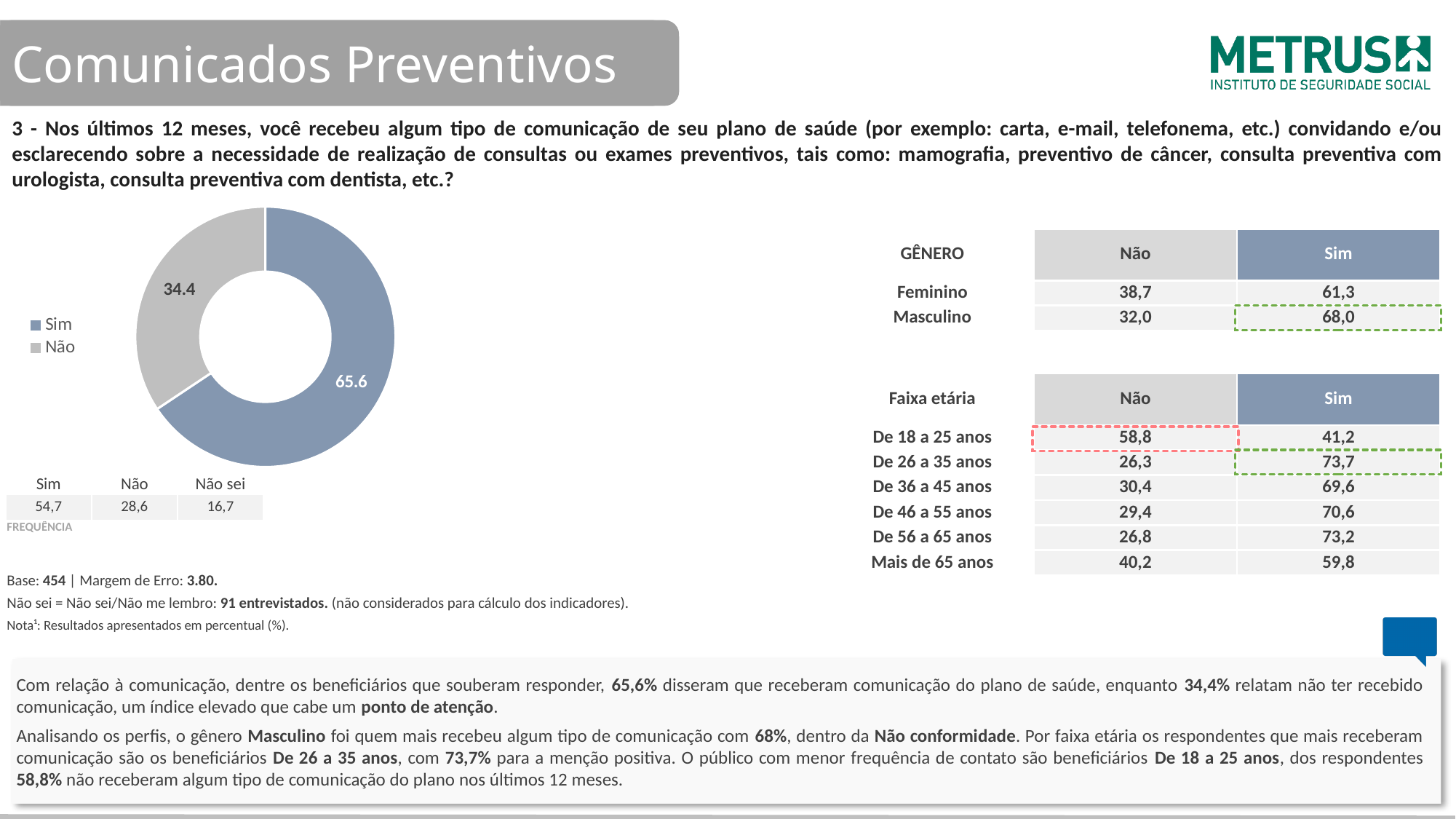
Which slice of the donut chart is the largest? Sim Which colour represents "Não" in the donut chart? Grey What is the difference between the "Sim" and "Não" values in the donut chart? 31.2 How many slices does the donut chart have? 2 What value is shown for the "Sim" slice of the donut chart? 65.6 In the donut chart, is the value for "Sim" larger or smaller than the value for "Não"? larger Which slice of the donut chart is the smallest? Não What kind of chart is shown on the slide? Donut (pie) chart How many entries does the legend of the donut chart list? 2 What share of the donut chart does the "Não" slice represent? 34.4 What value is shown for the "Não" slice of the donut chart? 34.4 Which colour represents "Sim" in the donut chart? Blue